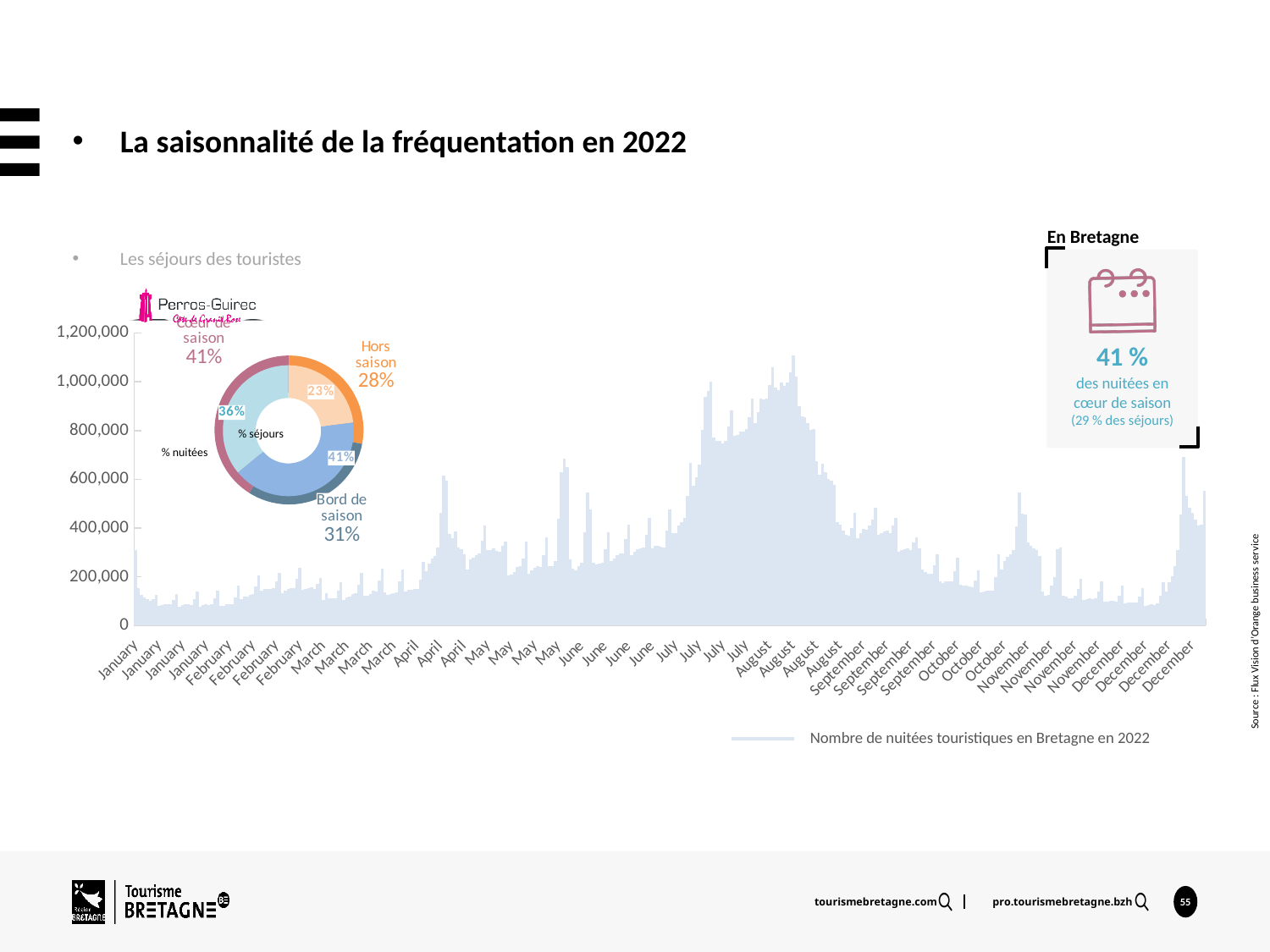
In the large chart, do the values generally rise or fall from August to November? fall In the large chart, which month has the highest values, August or March? August In the large chart, do the values generally rise or fall from January to August? rise In the donut chart, what percentage is labelled for Bord de saison? 31% What is the highest value shown on the y axis of the large chart? 1,200,000 What does the legend of the large chart say the series represents? Nombre de nuitées touristiques en Bretagne en 2022 In the donut chart, which of the three labelled seasons has the largest percentage? Cœur de saison In the donut chart, what is the difference between the Cœur de saison percentage (41%) and the Hors saison percentage (28%)? 13% In the donut chart, what percentage is labelled for Hors saison? 28% What kind of chart is the large chart showing tourist nights across the year? bar chart In the large chart, is the peak value in August greater or less than 1,000,000? greater